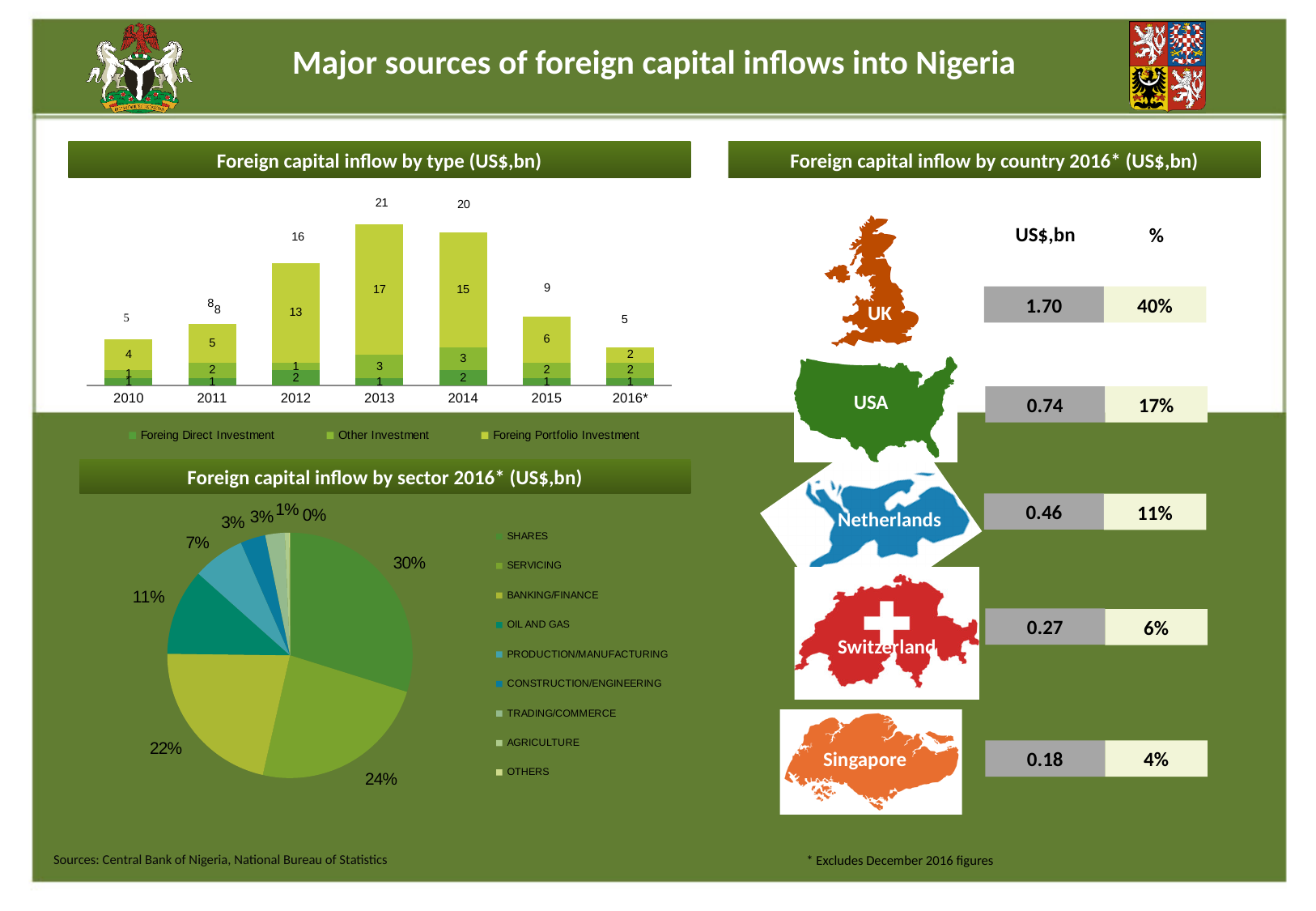
In the 'Foreign capital inflow by sector 2016*' pie chart, how many sectors are listed in the legend? 9 In the 'Foreign capital inflow by type' chart, what was the Foreign Portfolio Investment value in 2014? 15 In the 'Foreign capital inflow by sector 2016*' pie chart, which is larger, SERVICING or BANKING/FINANCE? SERVICING In the 'Foreign capital inflow by type' chart, how many series does the legend list? 3 In the 'Foreign capital inflow by type' chart, how many years are shown on the x axis? 7 In the 'Foreign capital inflow by sector 2016*' pie chart, which sector has the largest share? SHARES In the 'Foreign capital inflow by type' chart, what is the difference between the total inflow in 2013 and the total inflow in 2015? 12 What kind of chart is 'Foreign capital inflow by type (US$,bn)'? stacked bar chart In the 'Foreign capital inflow by type' chart, what was the total foreign capital inflow in 2013? 21 In the 'Foreign capital inflow by type' chart, did the total inflow rise or fall from 2014 to 2016*? fall In the 'Foreign capital inflow by type' chart, which year had the highest total inflow? 2013 In the 'Foreign capital inflow by sector 2016*' pie chart, what share does SHARES have? 30%